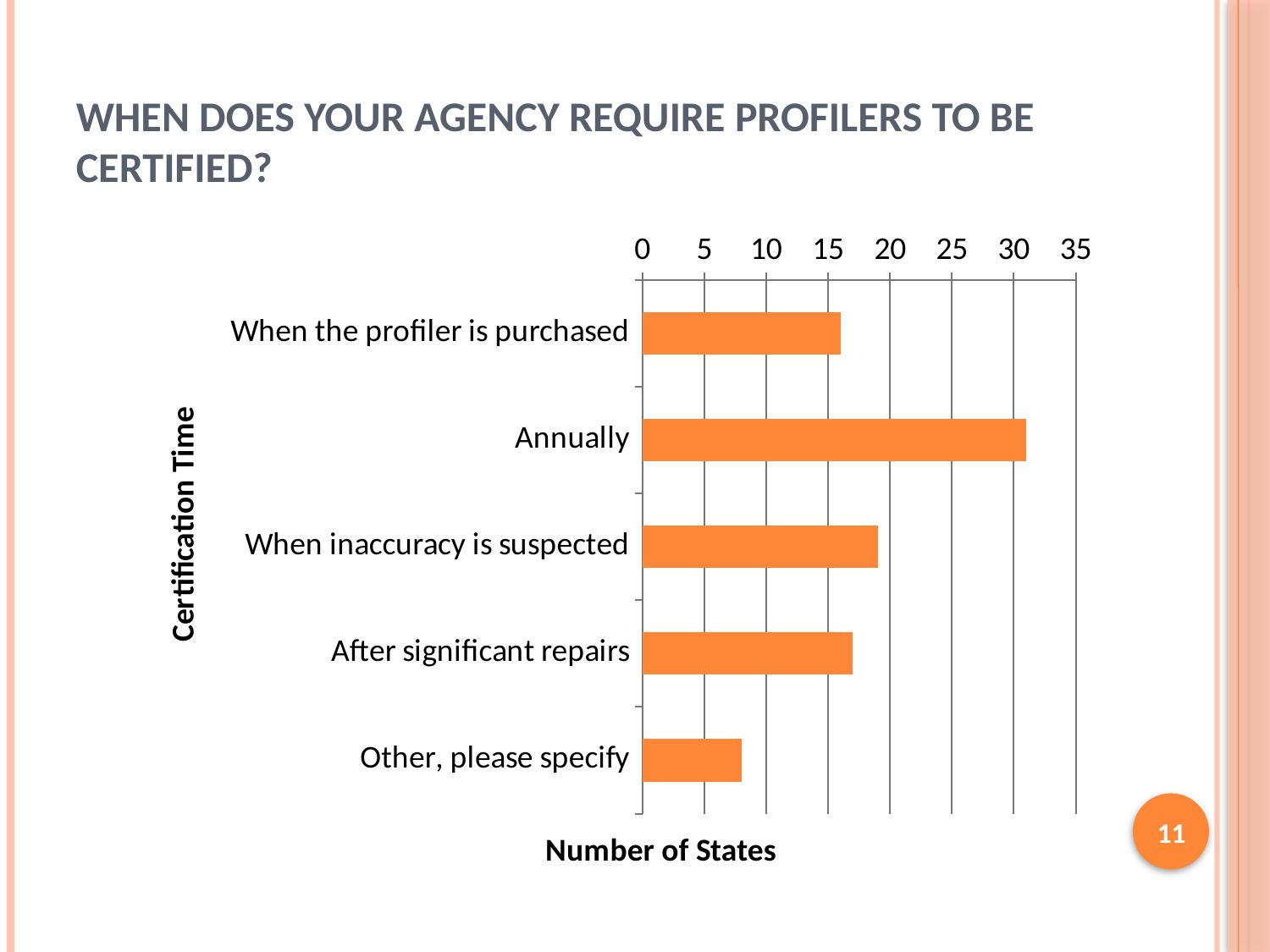
Is the value for When the profiler is purchased greater or less than 20? less Is the value for After significant repairs greater or less than 15? greater Is the value for Annually greater or less than 25? greater What is the label of the horizontal axis of the chart? Number of States What kind of chart is shown on the slide? bar chart Which has fewer states: Other, please specify or When the profiler is purchased? Other, please specify How many certification time categories are plotted in the chart? 5 Which has more states: Annually or When inaccuracy is suspected? Annually Which certification time has the highest number of states? Annually Which certification time has the lowest number of states? Other, please specify